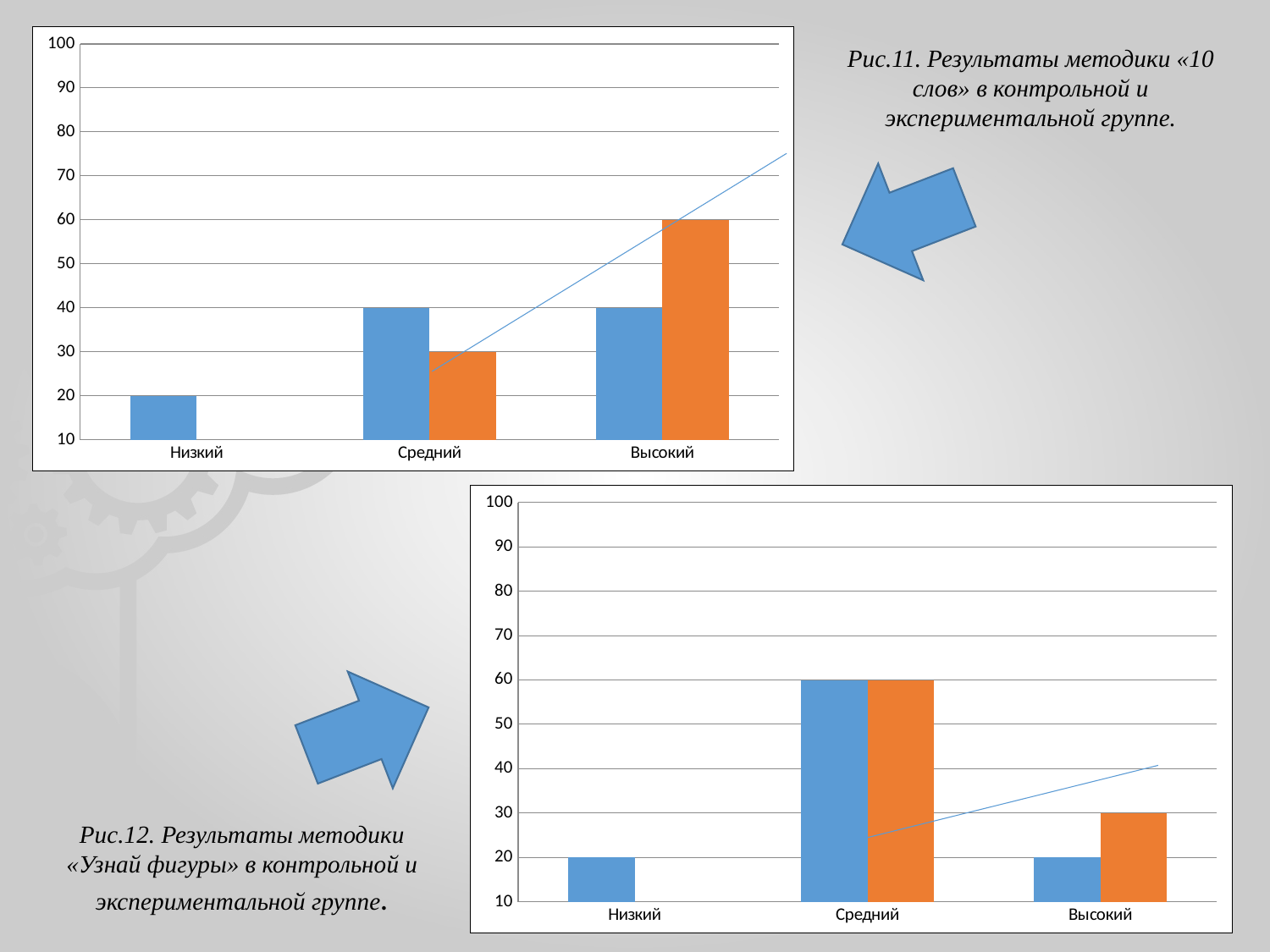
In the top chart (Рис.11), what is the difference between the orange bar and the blue bar for Высокий? 20 In the top chart (Рис.11), how many categories are shown on the x axis? 3 In the bottom chart (Рис.12), what is the value of the orange bar for Высокий? 30 What is the caption of the top chart? Рис.11. Результаты методики «10 слов» в контрольной и экспериментальной группе. In the top chart (Рис.11), what is the value of the orange bar for Высокий? 60 In the top chart (Рис.11), what is the value of the blue bar for Низкий? 20 In the top chart (Рис.11), which category has the tallest bar? Высокий In the bottom chart (Рис.12), is the value of the blue bar for Низкий greater or less than 50? less In the bottom chart (Рис.12), what is the value of the blue bar for Средний? 60 In the top chart (Рис.11), what is the value of the orange bar for Средний? 30 In the bottom chart (Рис.12), which is larger for Высокий: the blue bar or the orange bar? the orange bar What kind of chart is the bottom chart (Рис.12)? bar chart